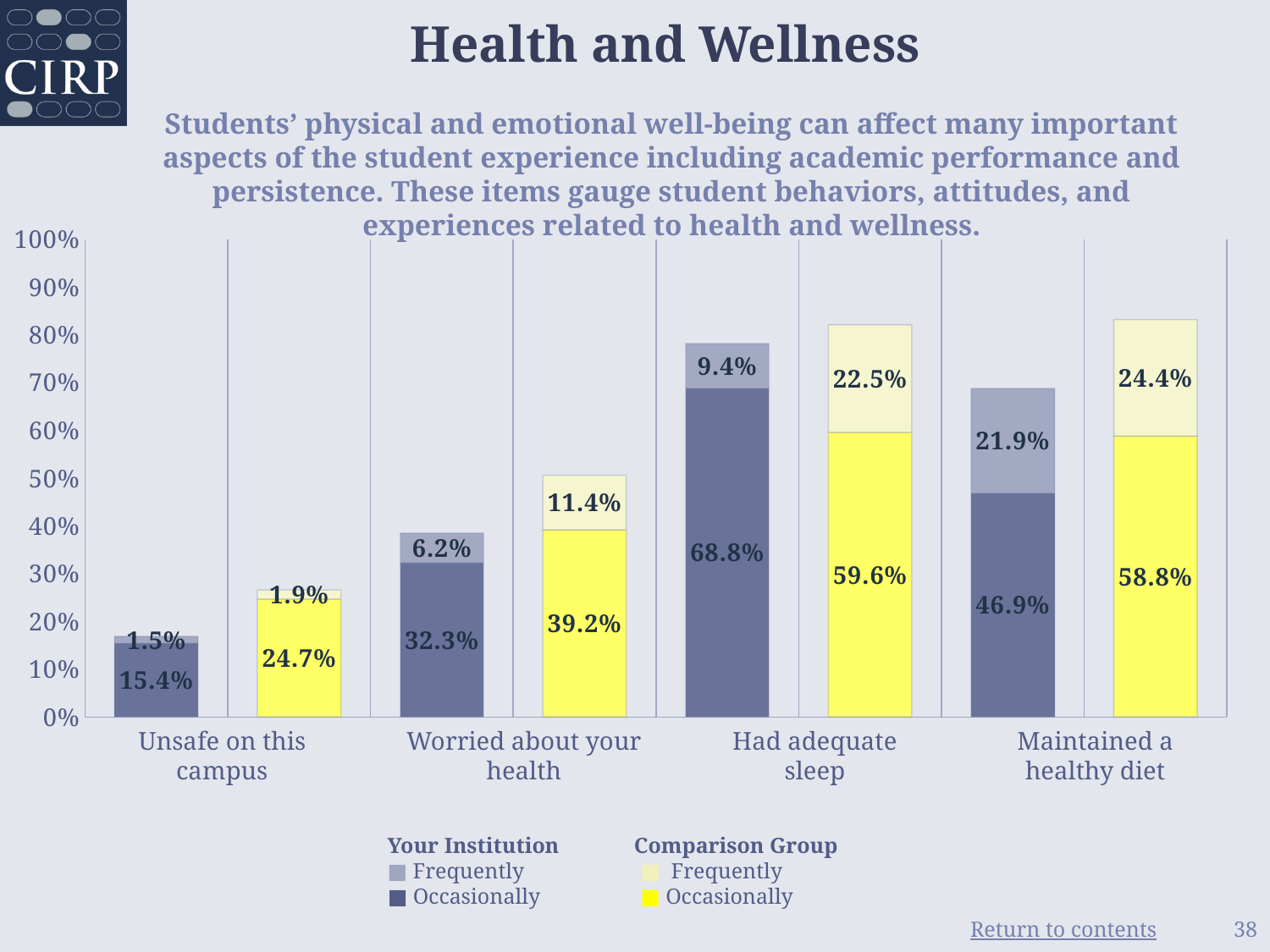
Which category has the lowest 'Frequently' value for the Comparison Group? Unsafe on this campus What is the total of the Comparison Group stacked bar for 'Unsafe on this campus'? 26.6% What is the 'Frequently' value for the Comparison Group for 'Maintained a healthy diet'? 24.4% What is the total of the Your Institution stacked bar for 'Maintained a healthy diet'? 68.8% For 'Had adequate sleep', which is larger: the Your Institution 'Frequently' value or the Comparison Group 'Frequently' value? Comparison Group How many entries does the legend list? 4 Which category has the highest 'Occasionally' value for Your Institution? Had adequate sleep What is the 'Occasionally' value for Your Institution for 'Had adequate sleep'? 68.8% What is the 'Frequently' value for Your Institution for 'Unsafe on this campus'? 1.5% What is the 'Occasionally' value for the Comparison Group for 'Worried about your health'? 39.2% What is the difference between the Comparison Group 'Occasionally' value and the Your Institution 'Occasionally' value for 'Maintained a healthy diet'? 11.9% How many categories are shown on the x axis? 4